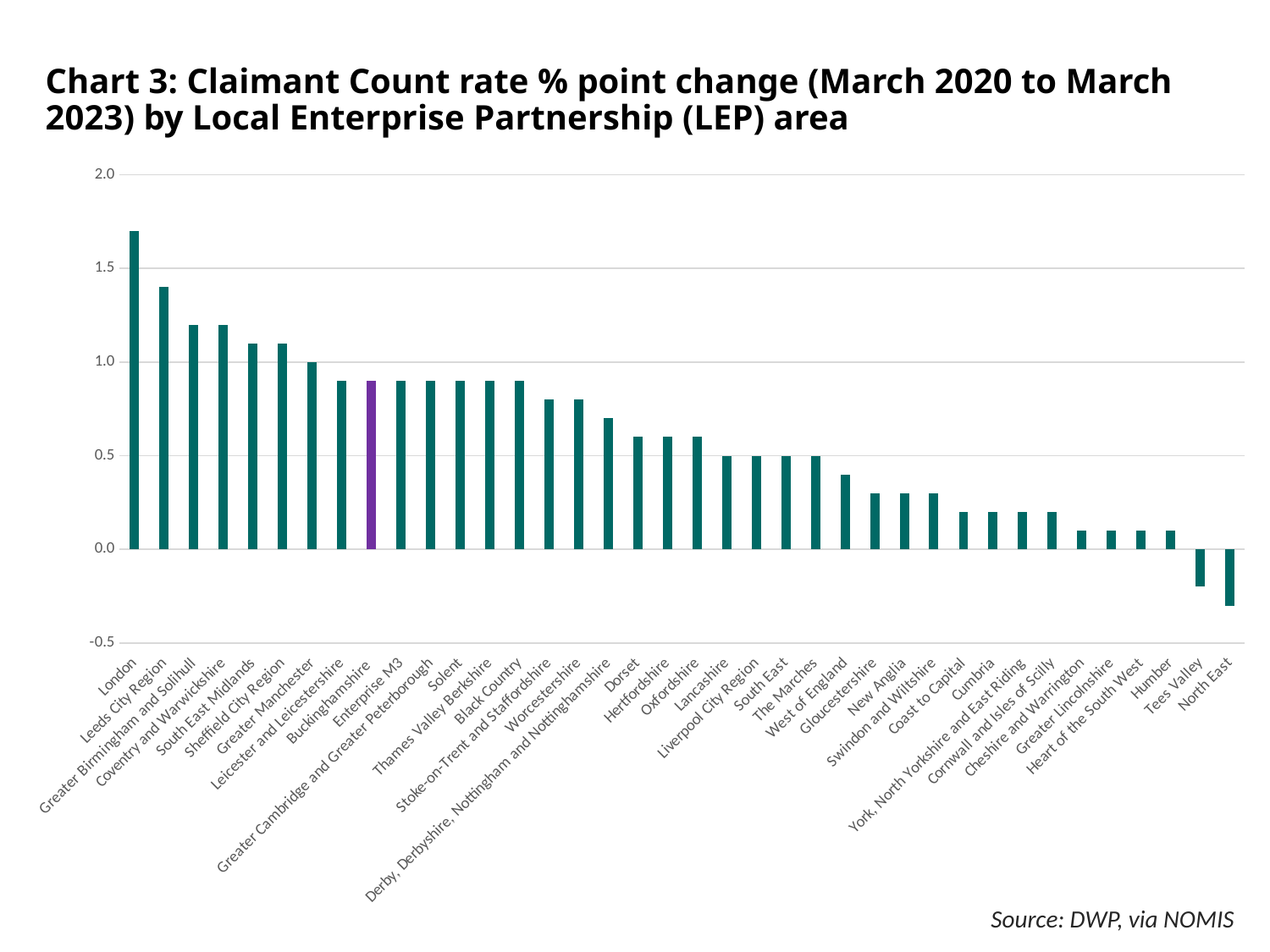
Which has the larger value, London or Leeds City Region? London Do the values rise or fall moving from left to right along the x axis? Fall Which LEP area has the lowest Claimant Count rate % point change? North East What source is cited for the chart? DWP, via NOMIS How many LEP areas are shown on the chart? 38 Which has the larger value, Dorset or West of England? Dorset Which LEP area has the highest Claimant Count rate % point change? London Is the value for London greater or less than 1.5? greater What kind of chart is shown on the slide? Bar chart Which bar is coloured purple rather than green? Buckinghamshire Is the value for Tees Valley greater or less than 0.0? less Is the value for Leeds City Region greater or less than 1.5? less